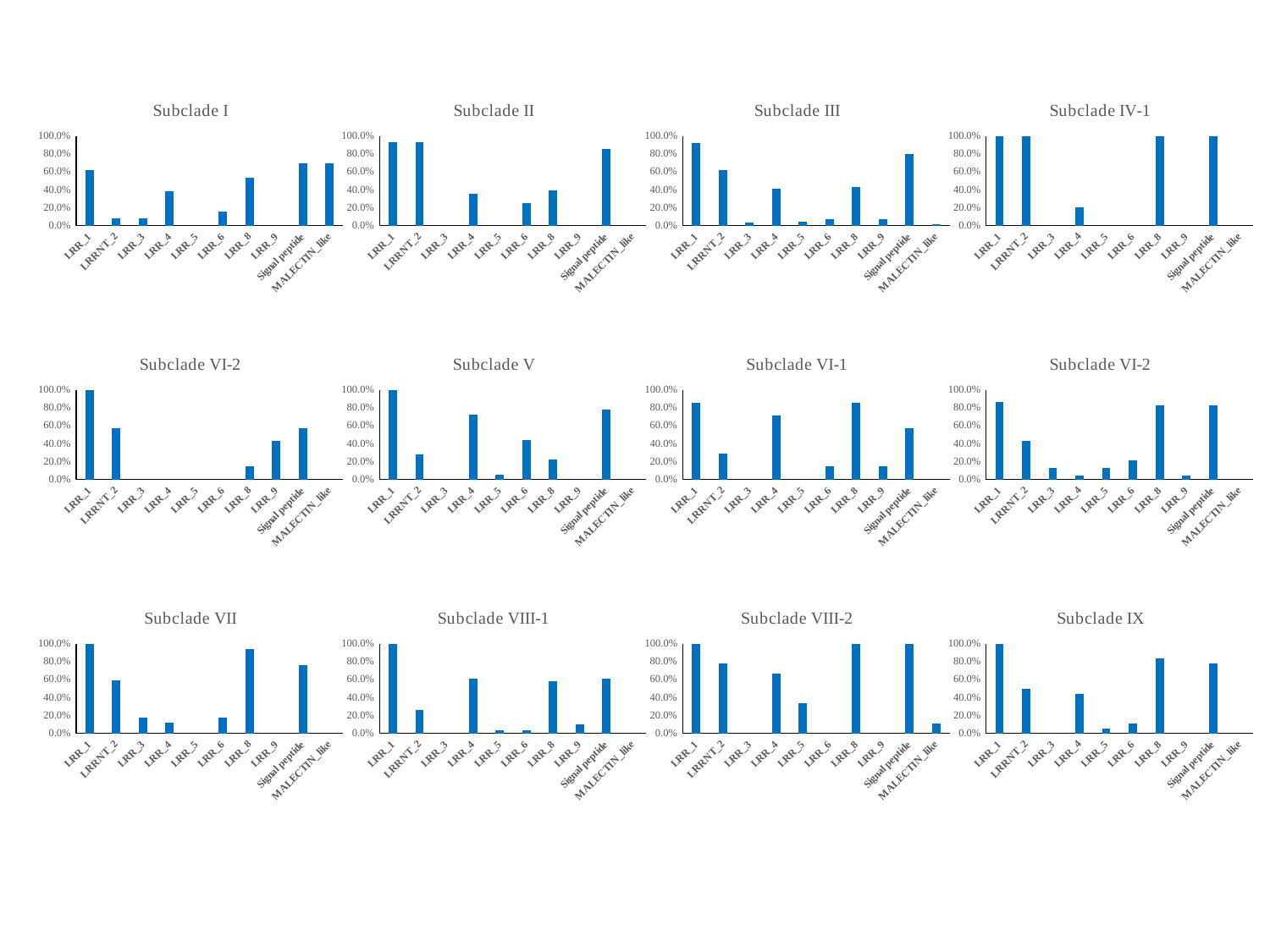
What is the title of the chart in the top-left corner of the slide? Subclade I In the Subclade II chart, is the value for LRR_1 greater or less than 80%? greater In the Subclade IV-1 chart, what is the value for LRR_8? 100.0% How many categories are shown on the x axis of the Subclade IX chart? 10 In the Subclade V chart, what is the value for LRR_1? 100.0% In the Subclade III chart, which category has the highest value? LRR_1 In the Subclade VI-1 chart, which is larger, the value for LRR_4 or the value for LRRNT_2? LRR_4 In the Subclade VIII-1 chart, what is the value for LRR_1? 100.0% In the Subclade IX chart, is the value for LRR_8 greater or less than 60%? greater In the Subclade VII chart, which is larger, the value for LRR_1 or the value for LRRNT_2? LRR_1 In the Subclade VIII-2 chart, is the value for LRRNT_2 greater or less than 60%? greater What kind of chart is the Subclade I chart? bar chart